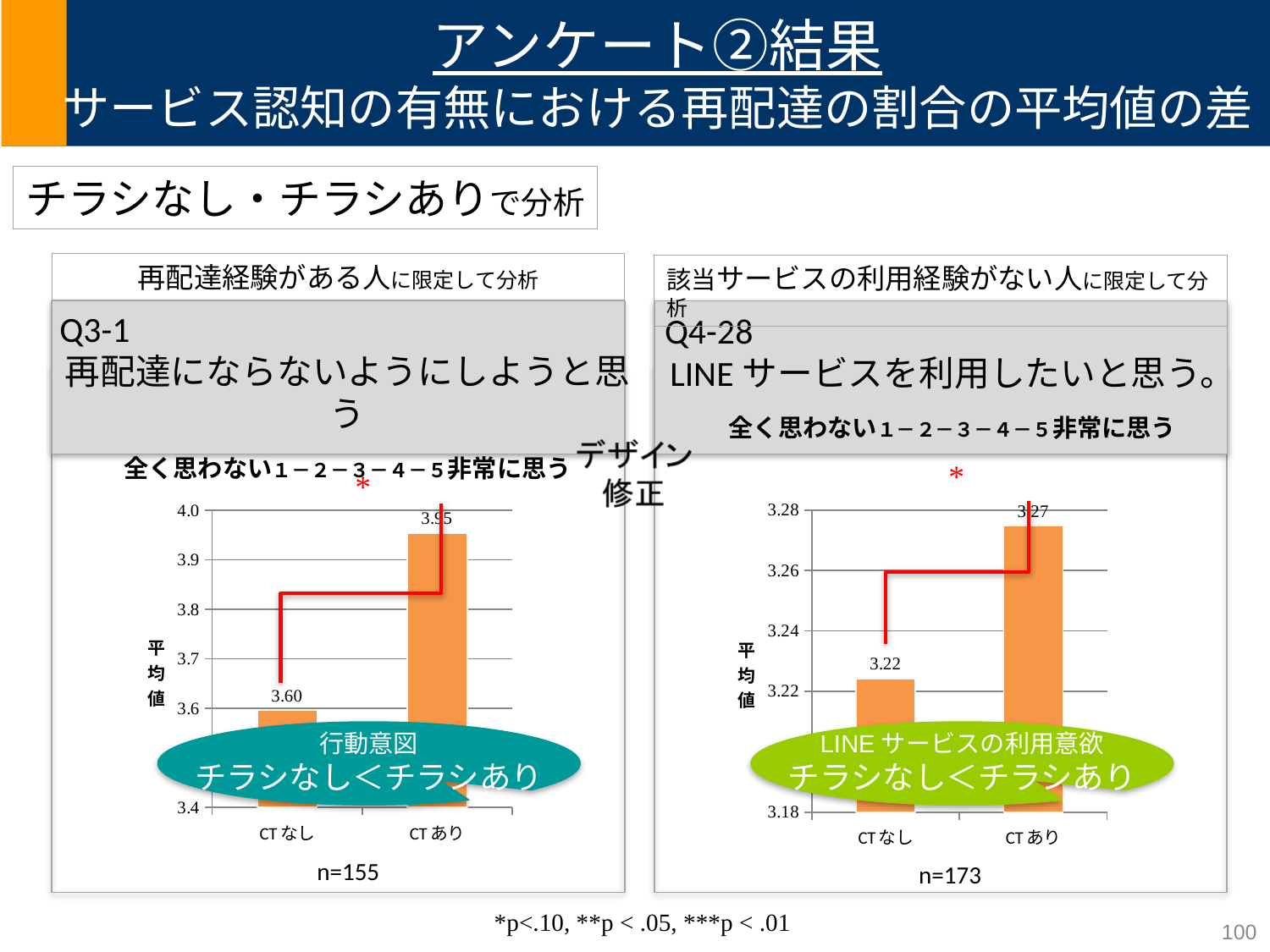
In the left chart (Q3-1), what is the value for CTなし? 3.60 In the right chart (Q4-28), what is the difference between the values for CTあり and CTなし? 0.05 In the left chart (Q3-1), is the value for CTなし greater or less than 3.7? less In the left chart (Q3-1), which category has the higher value? CTあり In the right chart (Q4-28), what is the value for CTあり? 3.27 In the left chart (Q3-1), what is the difference between the values for CTあり and CTなし? 0.35 In the right chart (Q4-28), what is the value for CTなし? 3.22 In the left chart (Q3-1), what is the value for CTあり? 3.95 How many categories are shown on the x axis of the right chart (Q4-28)? 2 What kind of chart is the left chart (Q3-1)? bar chart What is the y-axis label of the right chart (Q4-28)? 平均値 In the right chart (Q4-28), which category has the lower value? CTなし